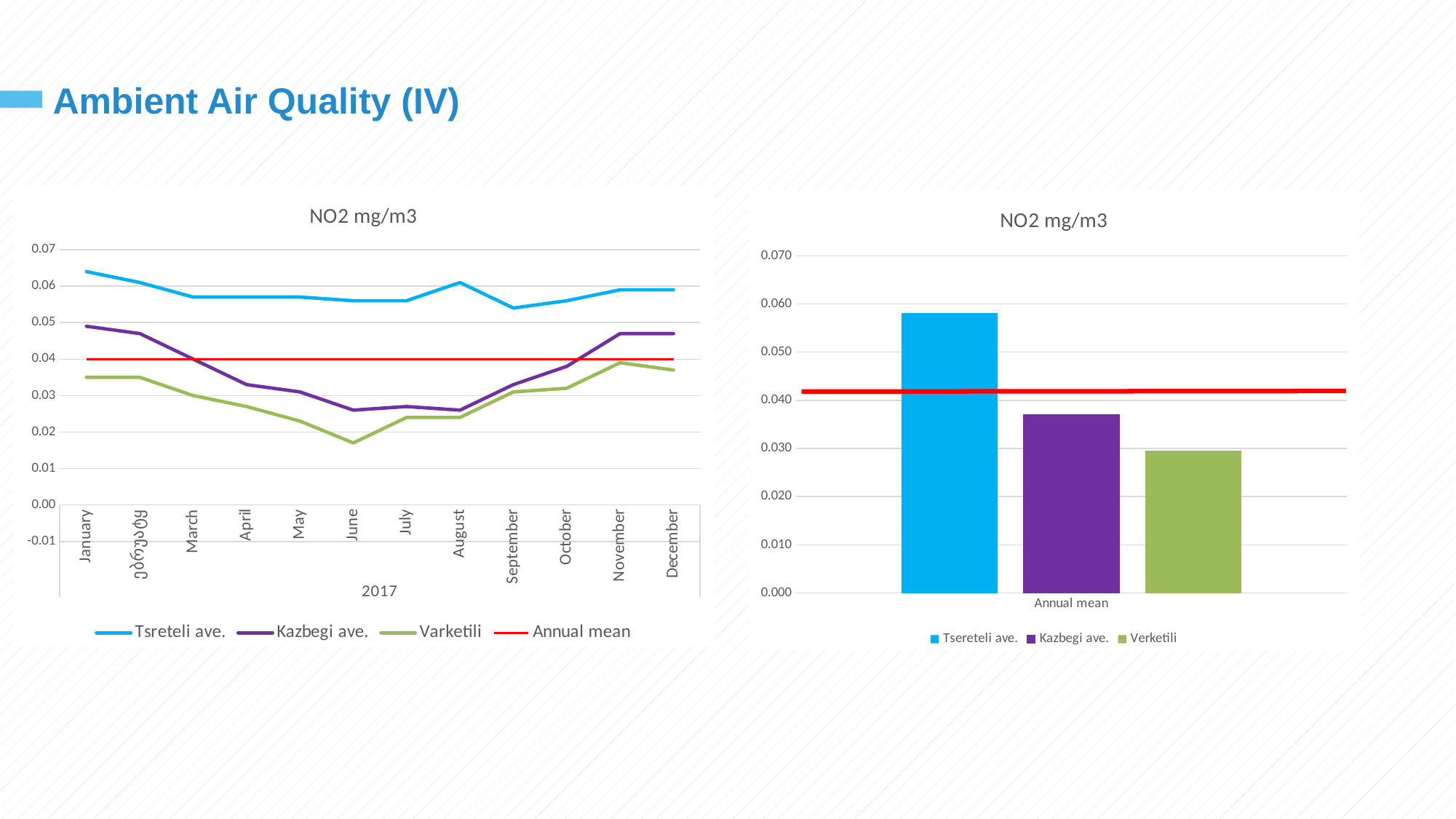
How many series does the legend of the left chart list? 4 In the left chart, does the Varketili line rise or fall from January to June? fall What kind of chart is the chart on the right side of the slide? bar chart In the right chart, is the value for Kazbegi ave. greater or less than 0.040? less In the left chart, is the value for Varketili in June greater or less than 0.02? less In the left chart, is the value for Kazbegi ave. in June greater or less than 0.03? less How many months are plotted along the x axis of the left chart? 12 In the right chart, which station has the highest annual mean bar? Tsereteli ave. How many series does the legend of the right chart list? 3 In the left chart, which series has the highest values across the year? Tsreteli ave. What kind of chart is the chart on the left side of the slide? line chart